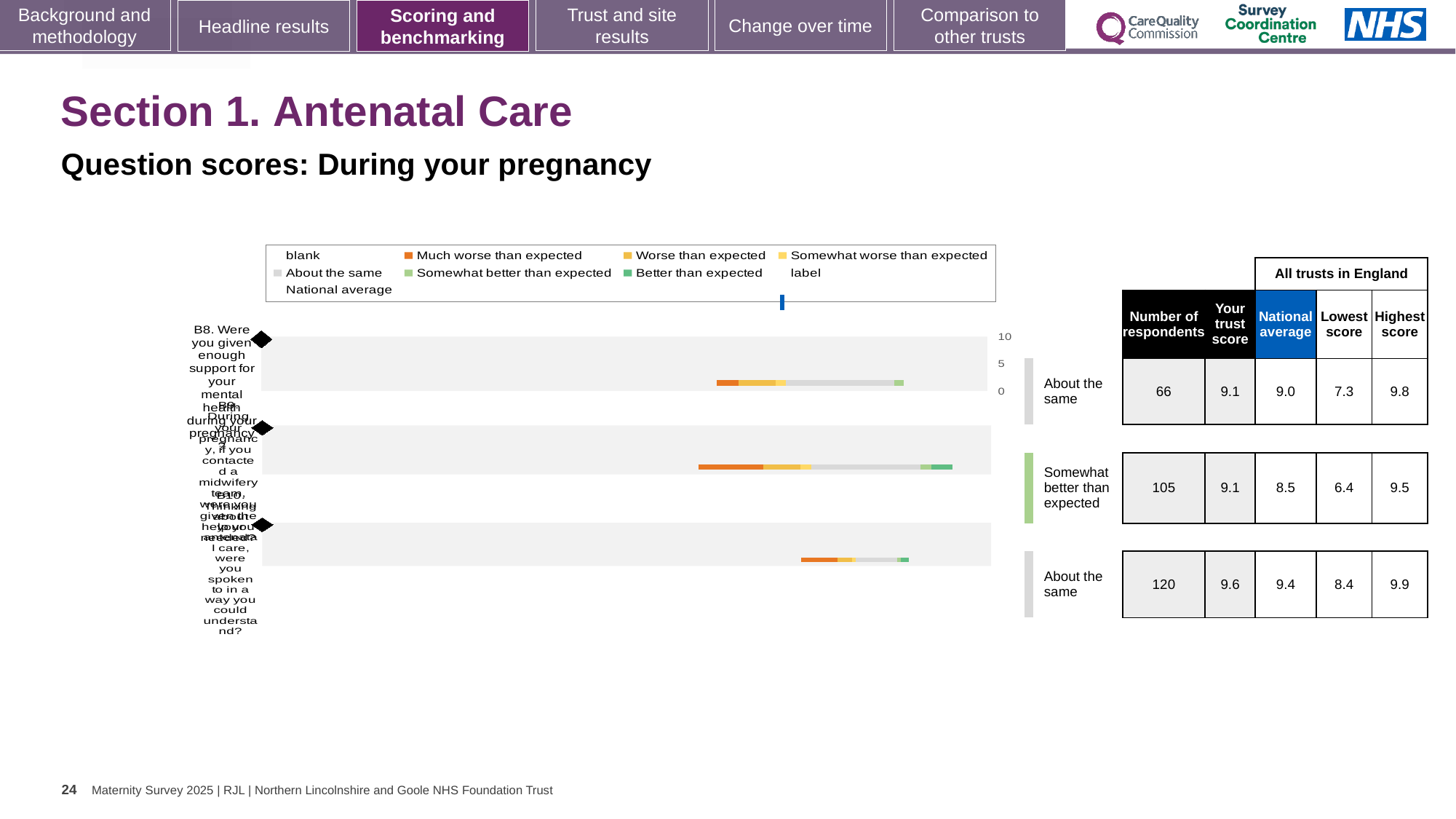
In the table next to the chart, what is the number of respondents for the first row (B8, support for your mental health during pregnancy)? 66 What benchmark category is given for the second row? Somewhat better than expected In the table next to the chart, what is the highest score for the third row? 9.9 Which row in the table has the highest number of respondents? the third row (120) In the table next to the chart, what is the national average for the first row (B8)? 9.0 For the second row, what is the difference between the trust score and the national average? 0.6 What kind of chart is shown on the slide? bar chart For the first row (B8), is the trust score higher or lower than the national average? higher In the table next to the chart, what is the lowest score for the second row? 6.4 In the table next to the chart, what is the trust score for the third row? 9.6 Which colour does the legend use for 'Much worse than expected'? orange How many questions (bars) are plotted in the chart? 3